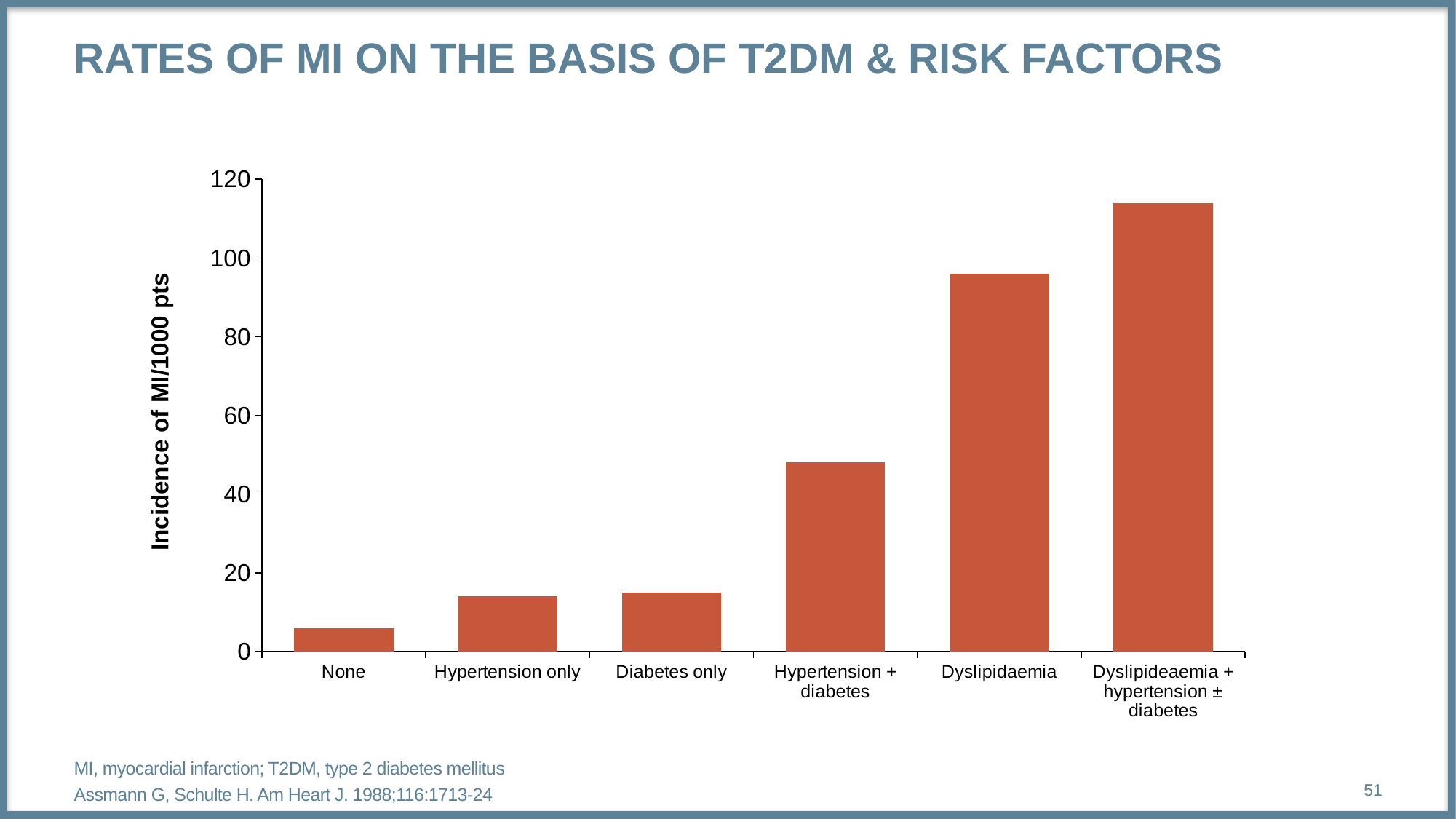
Is the value for Hypertension + diabetes greater or less than 40? greater What is the label of the y axis? Incidence of MI/1000 pts How many risk-factor categories are plotted on the x axis? 6 Is the value for Dyslipideaemia + hypertension ± diabetes greater or less than 100? greater What kind of chart is shown on the slide? bar chart Which category has the lowest incidence of MI/1000 pts? None Which has a lower incidence of MI: None or Hypertension only? None Do the bar values generally rise or fall from left to right along the x axis? rise Which category has the highest incidence of MI/1000 pts? Dyslipideaemia + hypertension ± diabetes Which has a higher incidence of MI: Dyslipidaemia or Hypertension + diabetes? Dyslipidaemia Is the value for Dyslipidaemia greater or less than 80? greater